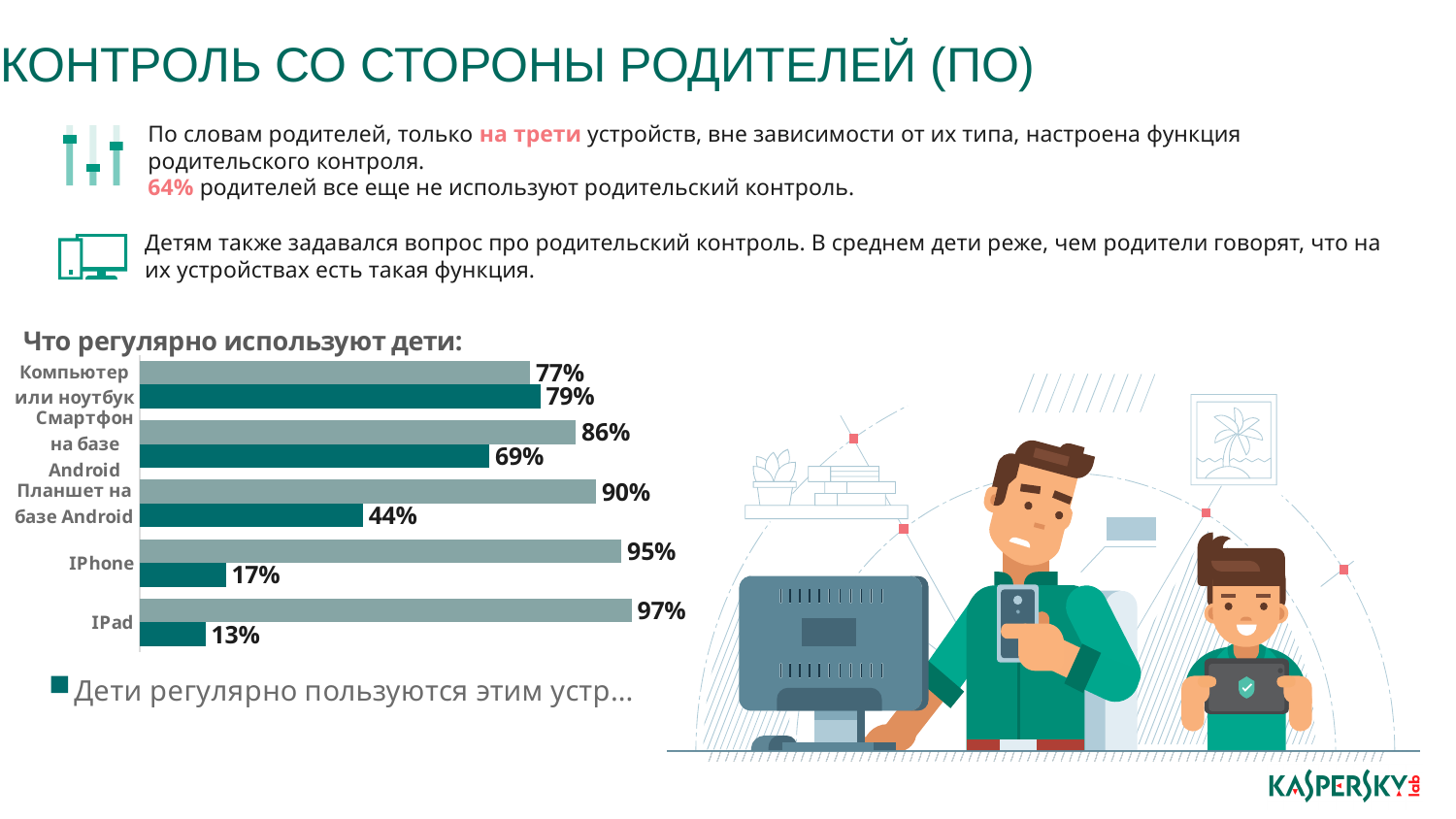
What is the value of the grey (upper) bar for IPad? 97% Which has the larger dark teal (lower) bar value: "Компьютер или ноутбук" or "Смартфон на базе Android"? Компьютер или ноутбук What kind of chart is shown under the heading "Что регулярно используют дети:"? bar chart What is the title shown above the bar chart? Что регулярно используют дети: What is the value of the dark teal (lower) bar for "Планшет на базе Android"? 44% What is the value of the dark teal (lower) bar for IPhone? 17% Do the grey (upper) bar values rise or fall going down the chart from "Компьютер или ноутбук" to IPad? rise What is the value of the grey (upper) bar for "Смартфон на базе Android"? 86% How many device categories are plotted in the chart? 5 Which category has the lowest dark teal (lower) bar value? IPad What is the difference between the grey bar and the dark teal bar for IPhone? 78 percentage points Which category has the highest grey (upper) bar value? IPad